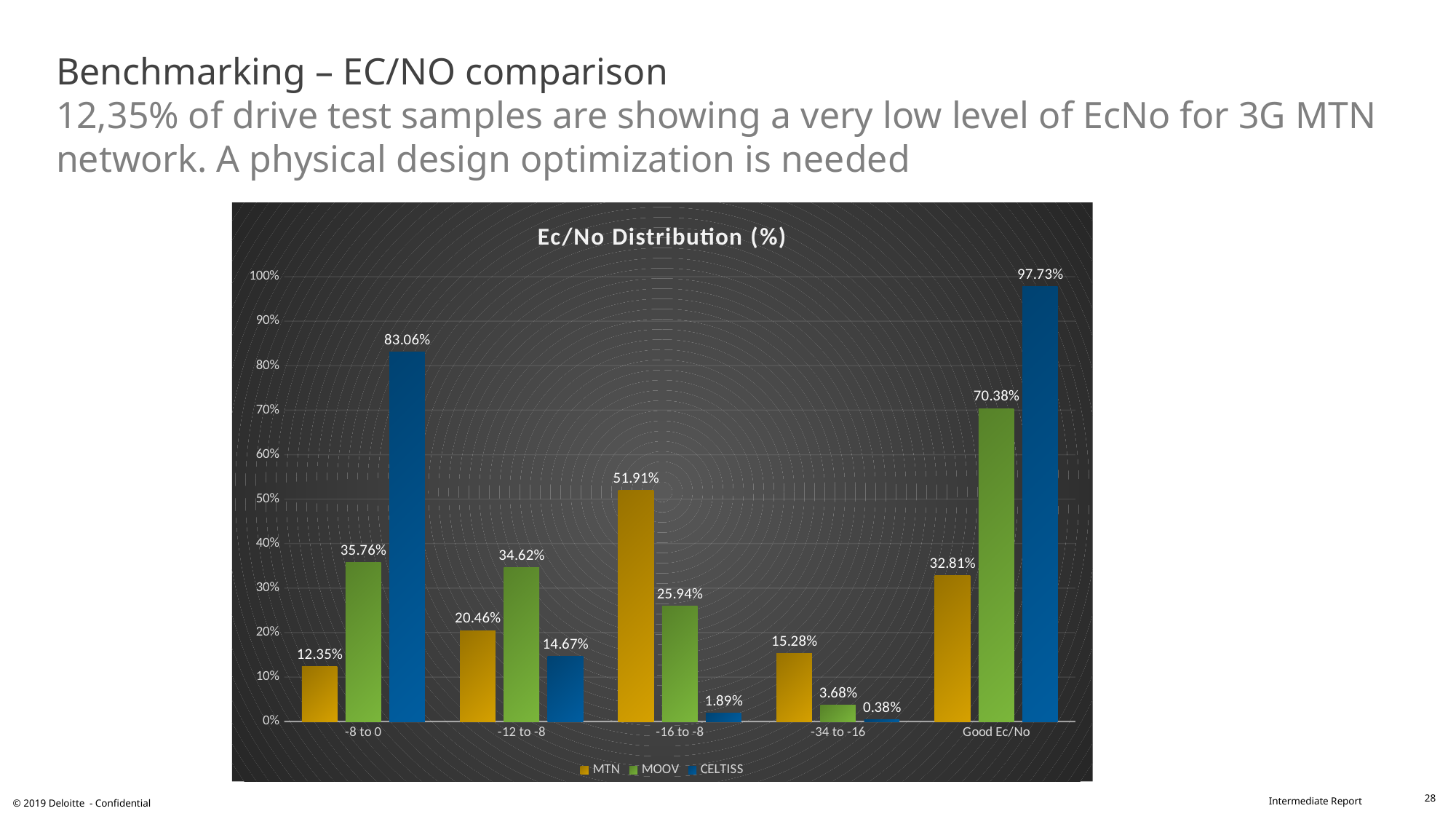
How many categories are shown on the x axis? 5 Which series has the lowest value in the -8 to 0 category? MTN What is the difference between the CELTISS and MTN values in the Good Ec/No category? 64.92% What is the value for CELTISS in the -8 to 0 category? 83.06% Which is larger in the -12 to -8 category, MTN or MOOV? MOOV Is the value for CELTISS in the -16 to -8 category greater or less than 10%? less How many series does the legend list? 3 What type of chart is shown on the slide? Bar chart What is the value for MTN in the -16 to -8 category? 51.91% Which series has the highest value in the -34 to -16 category? MTN What is the value for MOOV in the Good Ec/No category? 70.38% What is the title of the chart? Ec/No Distribution (%)